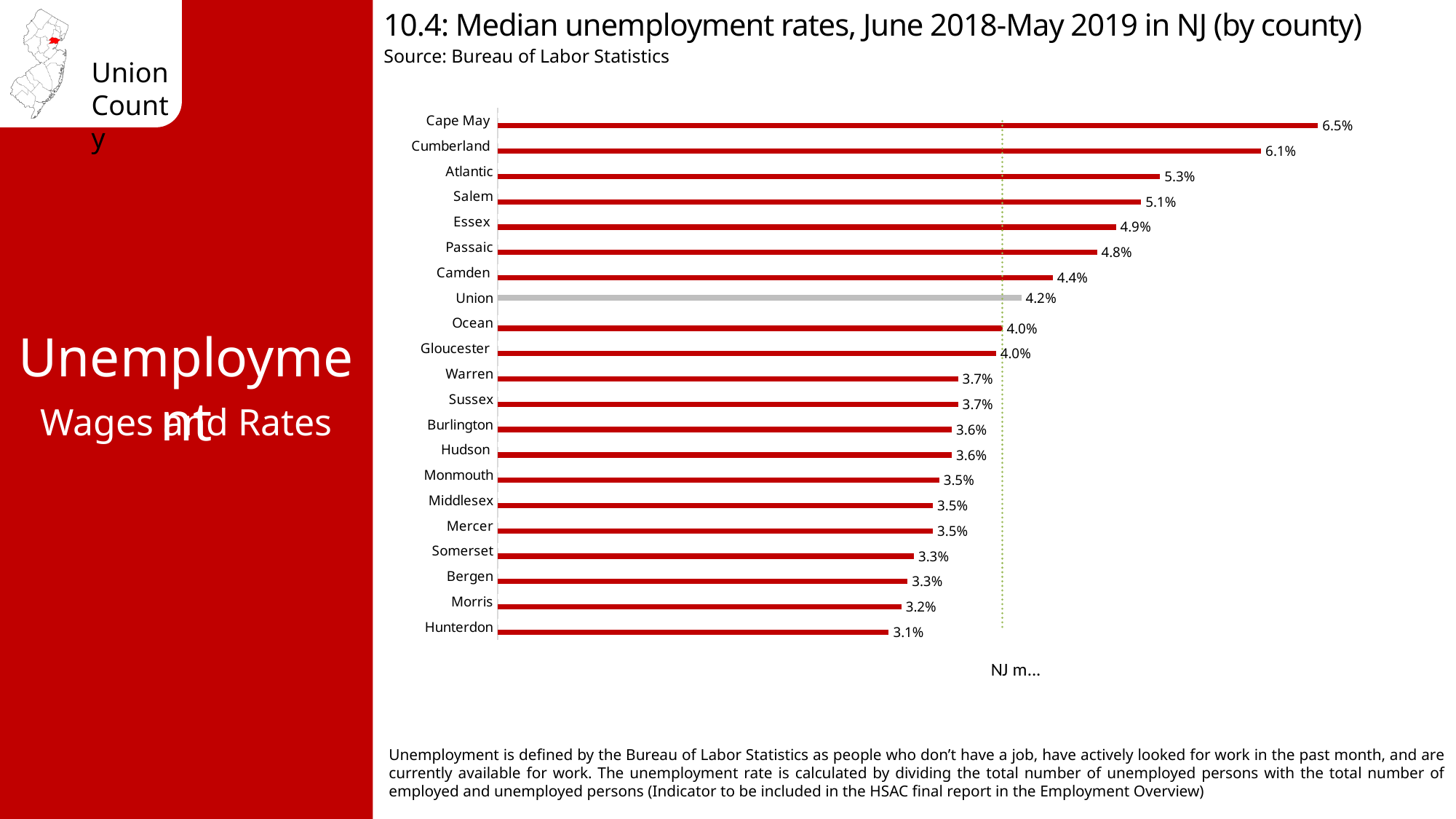
Which county has a higher median unemployment rate, Atlantic or Camden? Atlantic Which county's bar is shown in grey rather than red? Union What is the median unemployment rate for Hudson county? 3.6% Which county has the highest median unemployment rate? Cape May What is the difference between the median unemployment rates of Cape May and Hunterdon? 3.4% How many counties are shown in the chart? 21 What is the difference between the median unemployment rates of Essex and Union? 0.7% What is the median unemployment rate for Union county? 4.2% Which county has a higher median unemployment rate, Morris or Passaic? Passaic What type of chart is used to show the median unemployment rates? Bar chart What is the median unemployment rate for Cumberland county? 6.1% Which county has the lowest median unemployment rate? Hunterdon